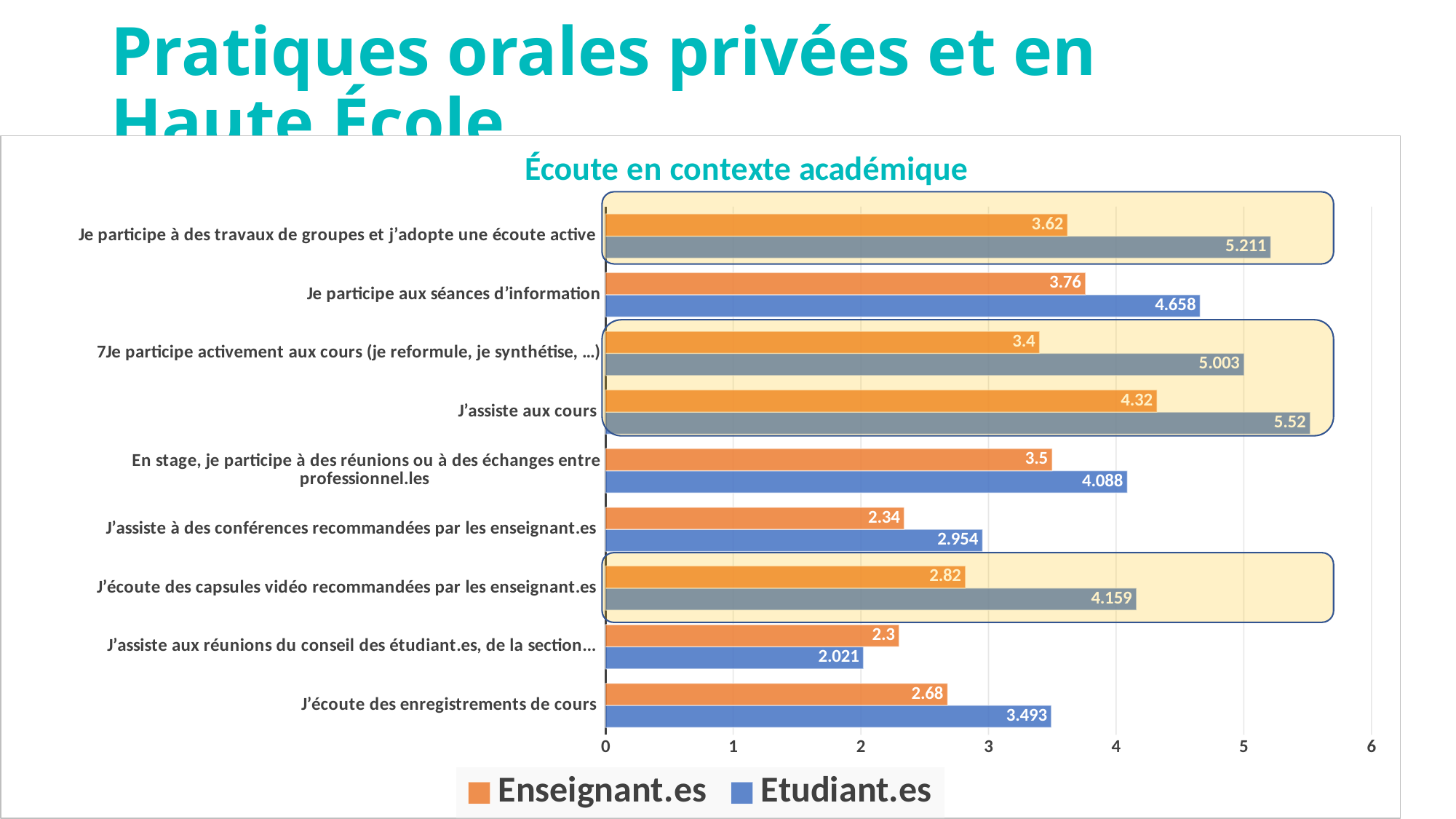
What kind of chart is shown on the slide? Bar chart How many categories are shown in the chart? 9 What is the difference between the Etudiant.es and Enseignant.es values for "J'assiste aux cours"? 1.2 What is the Etudiant.es value for "J'assiste aux cours"? 5.52 What is the title of the chart? Écoute en contexte académique What is the Enseignant.es value for "Je participe aux séances d'information"? 3.76 What is the Etudiant.es value for "J'écoute des capsules vidéo recommandées par les enseignant.es"? 4.159 How many series does the legend list? 2 Which category has the highest Etudiant.es value? J'assiste aux cours Which category has the lowest Etudiant.es value? J'assiste aux réunions du conseil des étudiant.es, de la section... What is the Enseignant.es value for "J'écoute des enregistrements de cours"? 2.68 For "J'assiste aux réunions du conseil des étudiant.es, de la section...", which series has the larger value, Enseignant.es or Etudiant.es? Enseignant.es